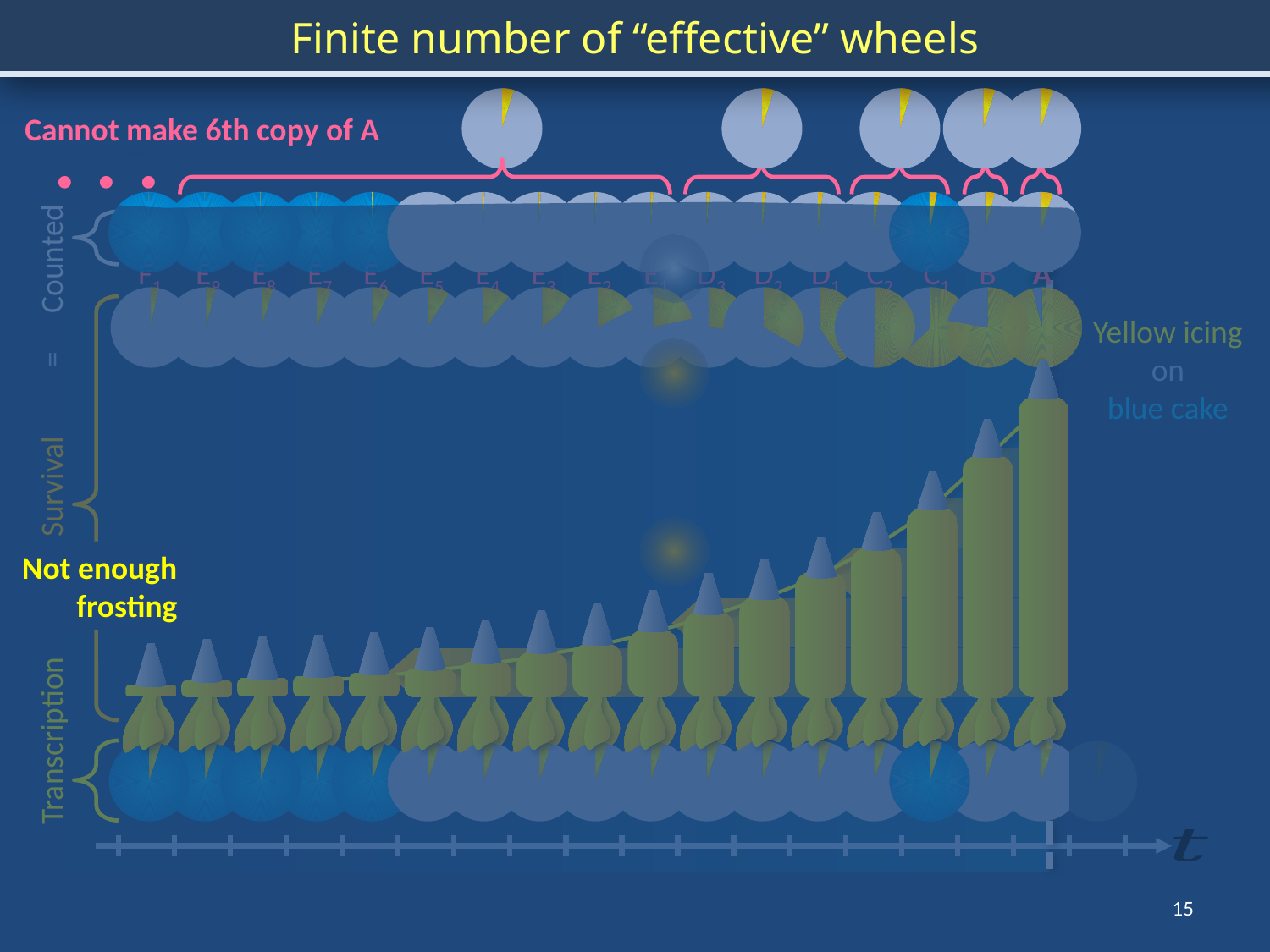
Do the heights of the rocket-shaped bars rise or fall moving left to right along the t axis? rise What is the label on the horizontal axis of the diagram? t What is the title of the slide's diagram? Finite number of "effective" wheels